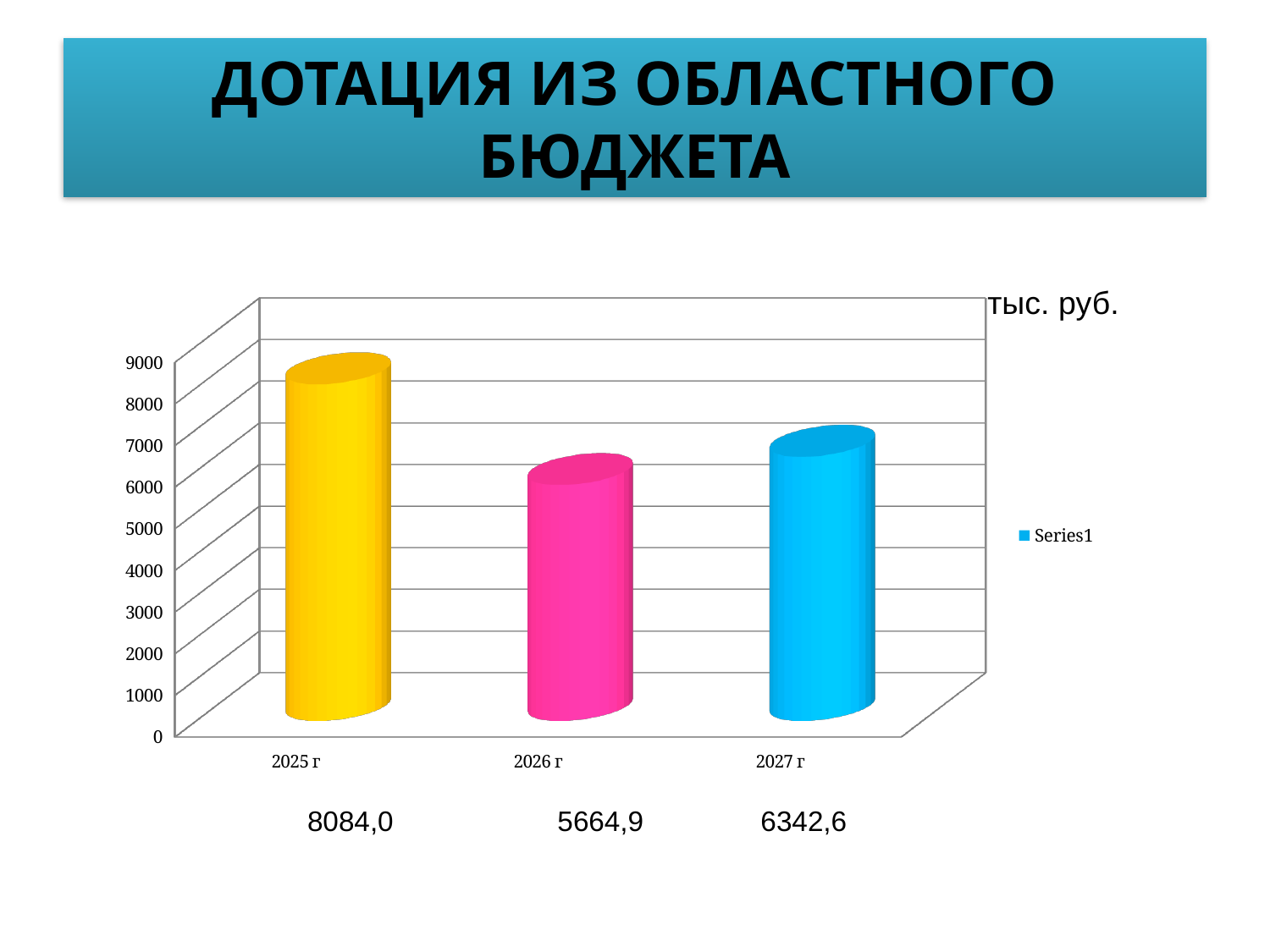
What is the difference between the values for 2025 г and 2026 г? 2419,1 What is the value for 2026 г? 5664,9 What is the value for 2027 г? 6342,6 What kind of chart is shown on the slide? bar chart Which year has the lowest value? 2026 г Which year has the highest value? 2025 г Which is larger, the value for 2027 г or the value for 2026 г? 2027 г How many years are shown on the chart? 3 Is the value for 2025 г greater or less than 7000? greater What is the value for 2025 г? 8084,0 What is the title of the slide? ДОТАЦИЯ ИЗ ОБЛАСТНОГО БЮДЖЕТА What is the difference between the values for 2027 г and 2026 г? 677,7